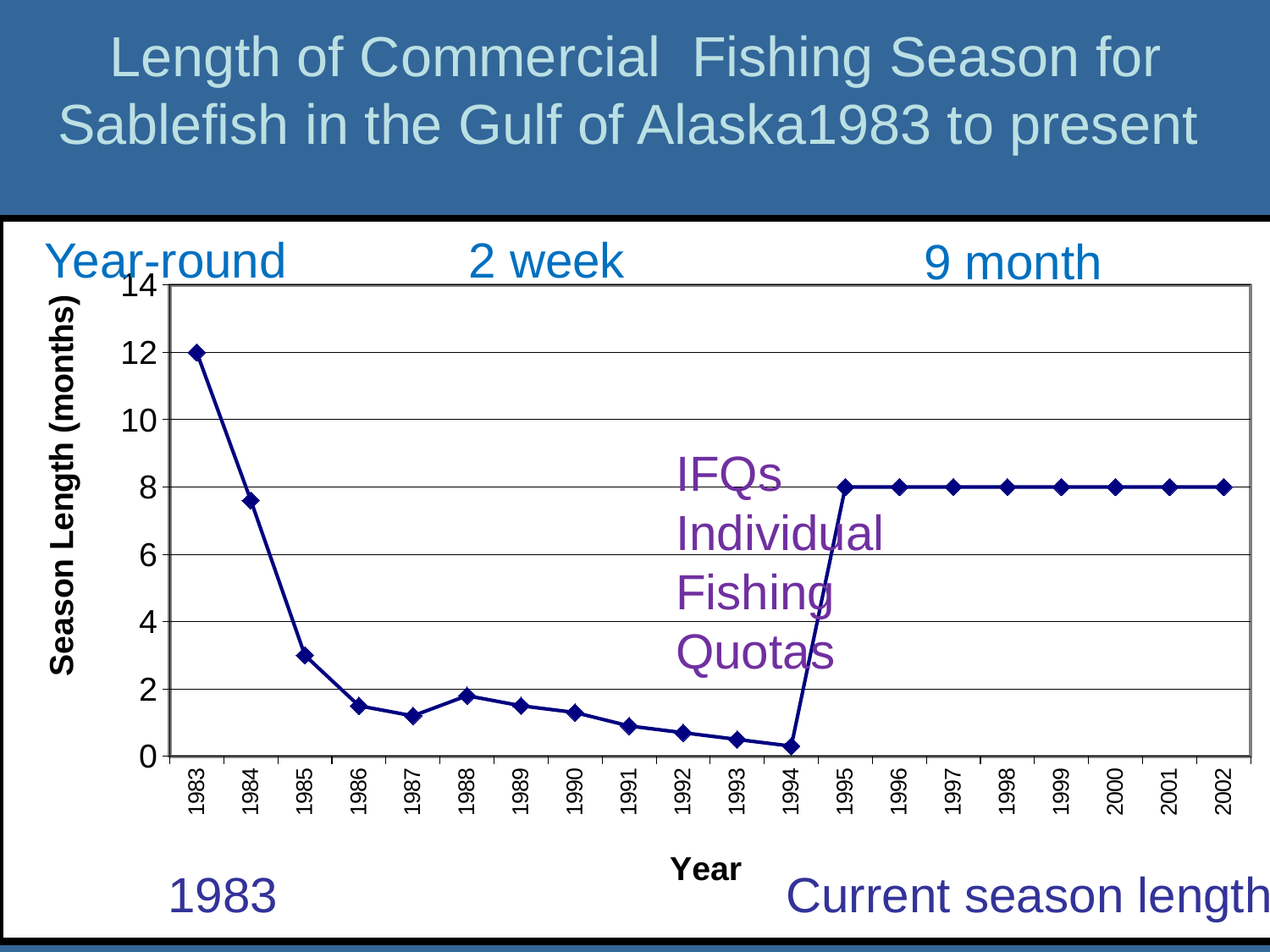
Which year has the highest season length? 1983 What is the season length in months for 2002? 8 How many years are plotted on the x axis? 20 What is the season length in months for 1995? 8 What kind of chart is shown on the slide? Line chart What is the season length in months for 1983? 12 Is the season length for 1984 greater or less than 6 months? greater What is the label on the y axis? Season Length (months) Which year has the lowest season length? 1994 Which year has a longer season, 1983 or 1995? 1983 Is the season length for 1985 greater or less than 4 months? less Does the season length rise or fall from 1983 to 1994? Fall